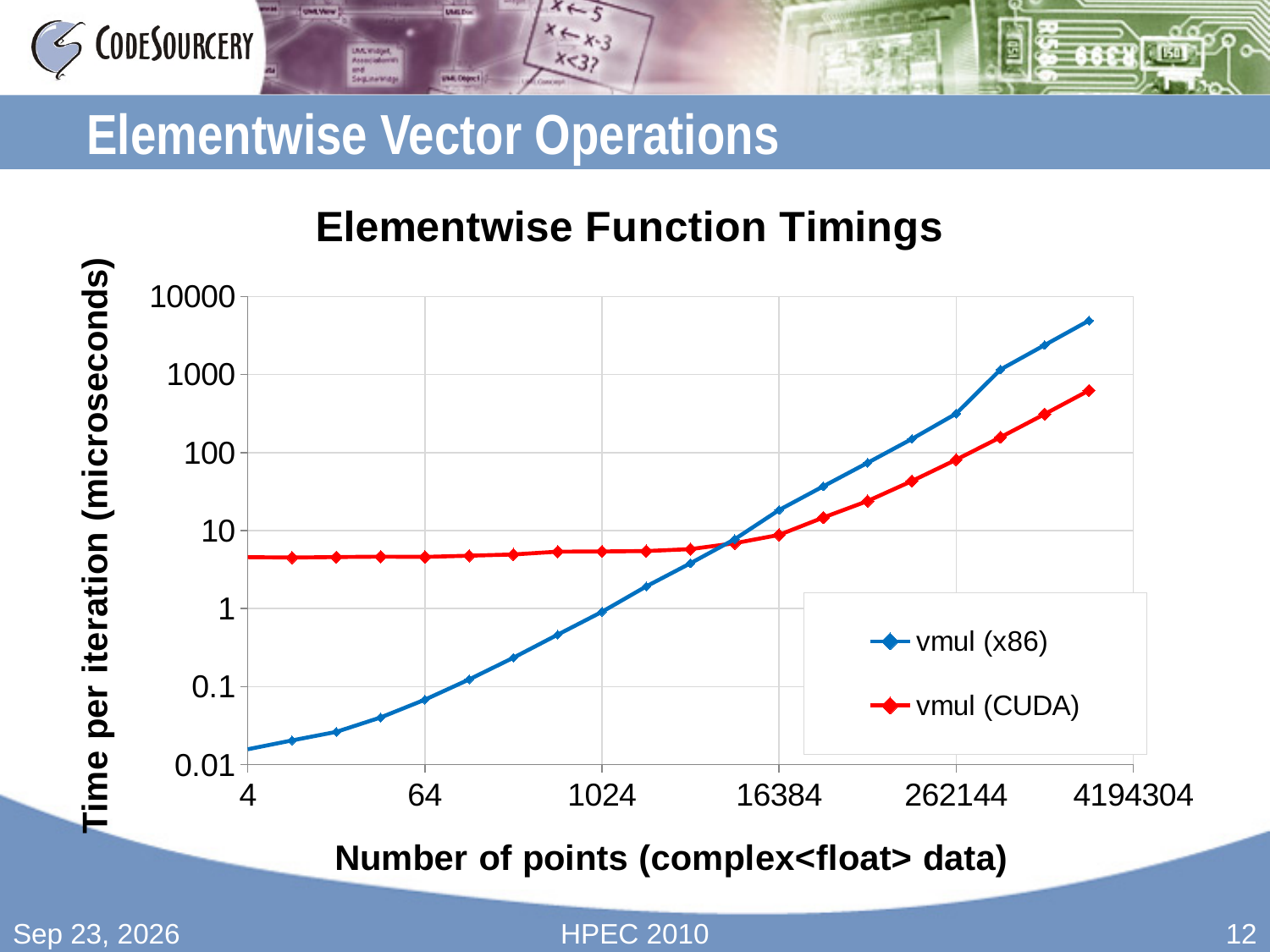
What kind of chart is shown on the slide? line chart What is the title of the chart? Elementwise Function Timings Does the vmul (x86) series rise or fall as the number of points increases? rise Is the value for vmul (CUDA) at 4 points greater or less than 10? less At 4 points, which series has the larger value, vmul (x86) or vmul (CUDA)? vmul (CUDA) How many series does the legend list? 2 What is the label of the y axis? Time per iteration (microseconds) Is the value for vmul (x86) at 4 points greater or less than 0.1? less Is the value for vmul (x86) at 64 points greater or less than 0.1? less